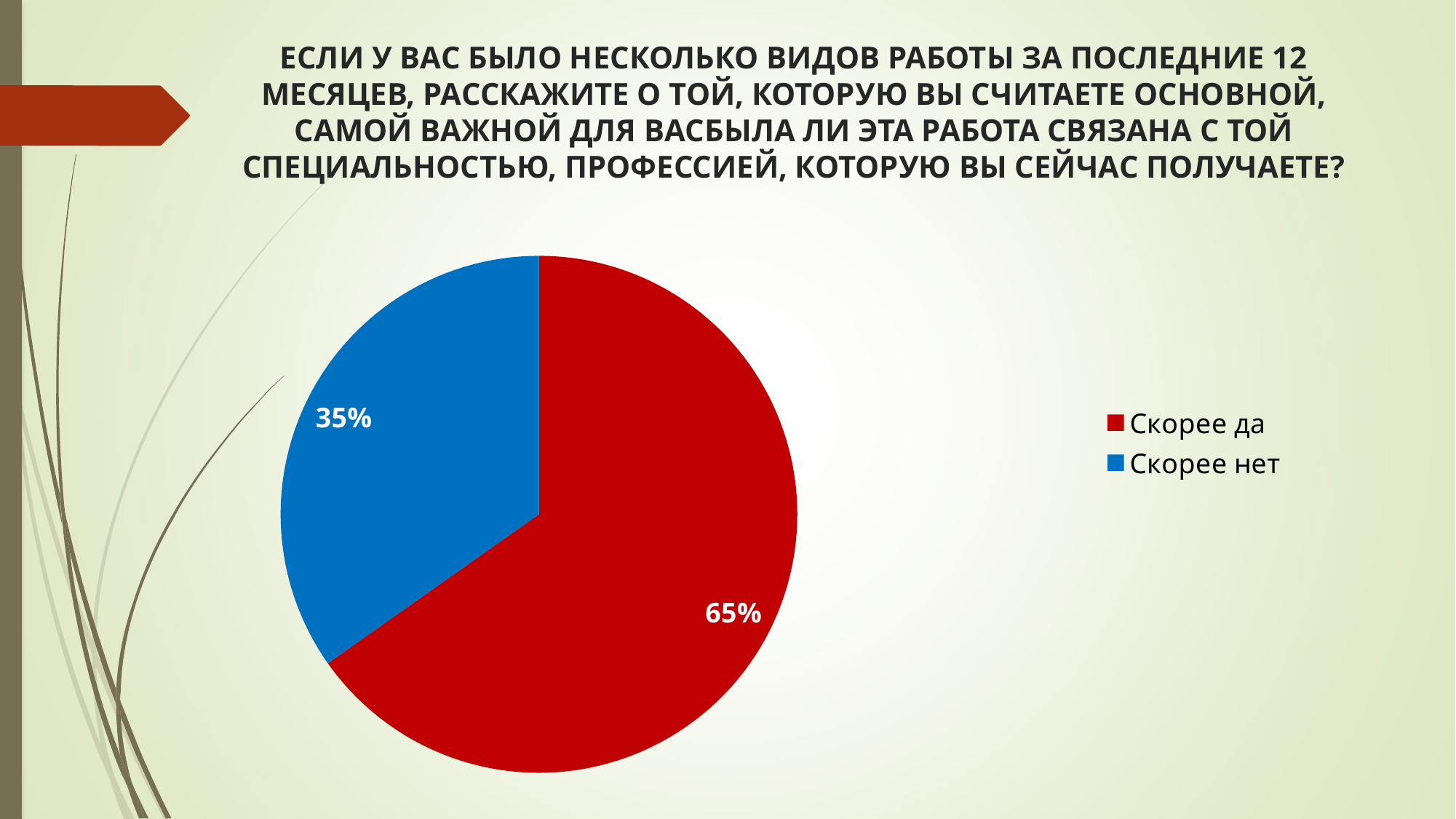
Which slice is larger, "Скорее да" or "Скорее нет"? Скорее да What share of the pie is labelled "Скорее да"? 65% What colour is the "Скорее да" slice? red What colour is the "Скорее нет" slice? blue Which category has the largest slice of the pie? Скорее да What is the difference in percentage points between the "Скорее да" and "Скорее нет" slices? 30 Which category has the smallest slice of the pie? Скорее нет What share of the pie is labelled "Скорее нет"? 35% How many slices does the pie chart have? 2 What kind of chart is shown on the slide? pie chart How many entries does the legend list? 2